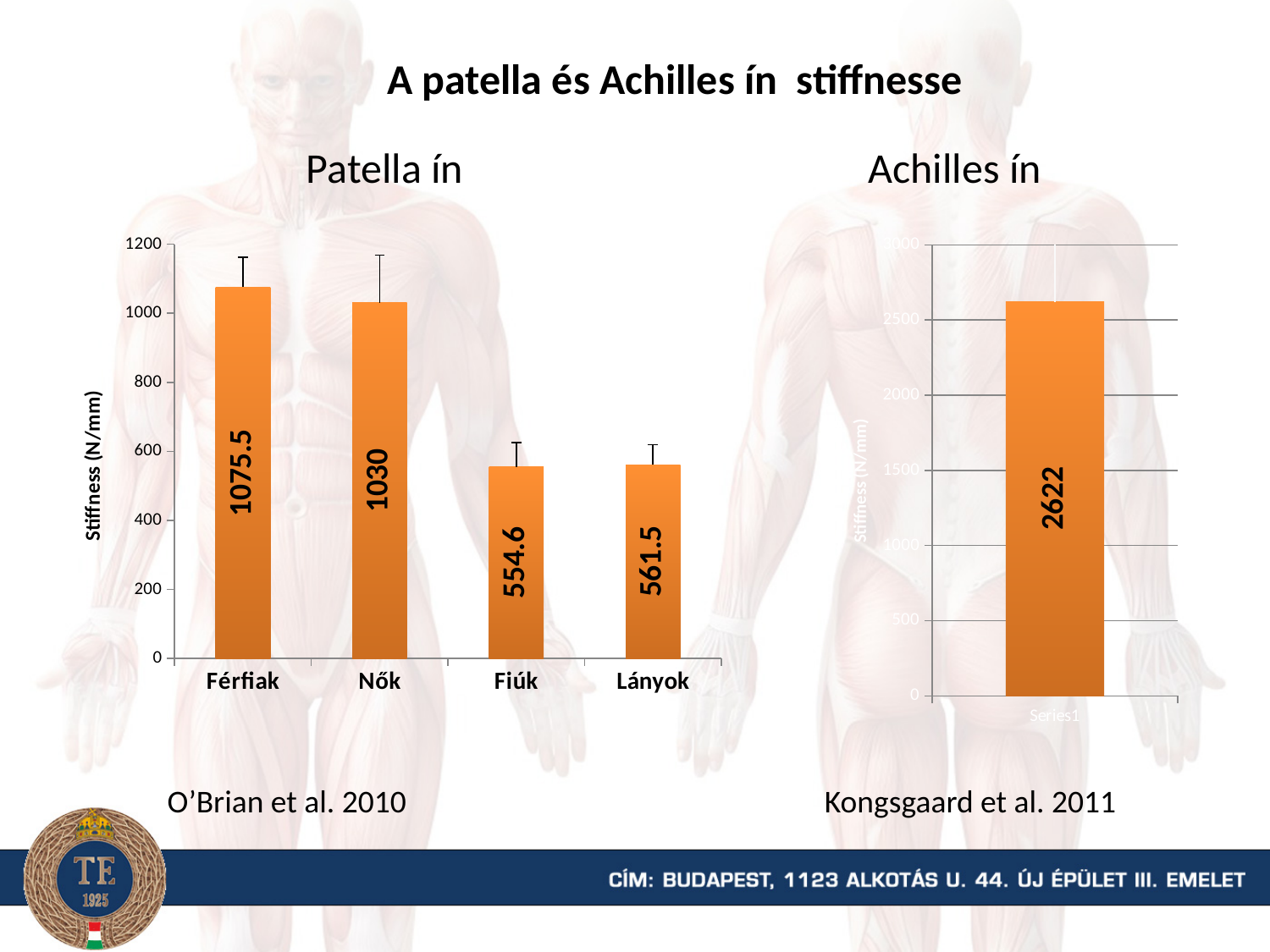
What is the y-axis label of the Patella ín chart? Stiffness (N/mm) In the Patella ín chart, which category has the lowest stiffness? Fiúk In the Achilles ín chart, what is the stiffness value shown on the bar? 2622 In the Patella ín chart, what is the stiffness value for Fiúk? 554.6 How many categories are shown in the Patella ín chart? 4 In the Patella ín chart, what is the difference between the values for Férfiak and Nők? 45.5 What type of chart is the Patella ín chart? bar chart In the Patella ín chart, is the value for Nők greater or less than 1000? greater In the Patella ín chart, what is the stiffness value for Lányok? 561.5 In the Patella ín chart, what is the stiffness value for Férfiak? 1075.5 In the Patella ín chart, which is larger, the value for Férfiak or the value for Nők? Férfiak In the Patella ín chart, which category has the highest stiffness? Férfiak